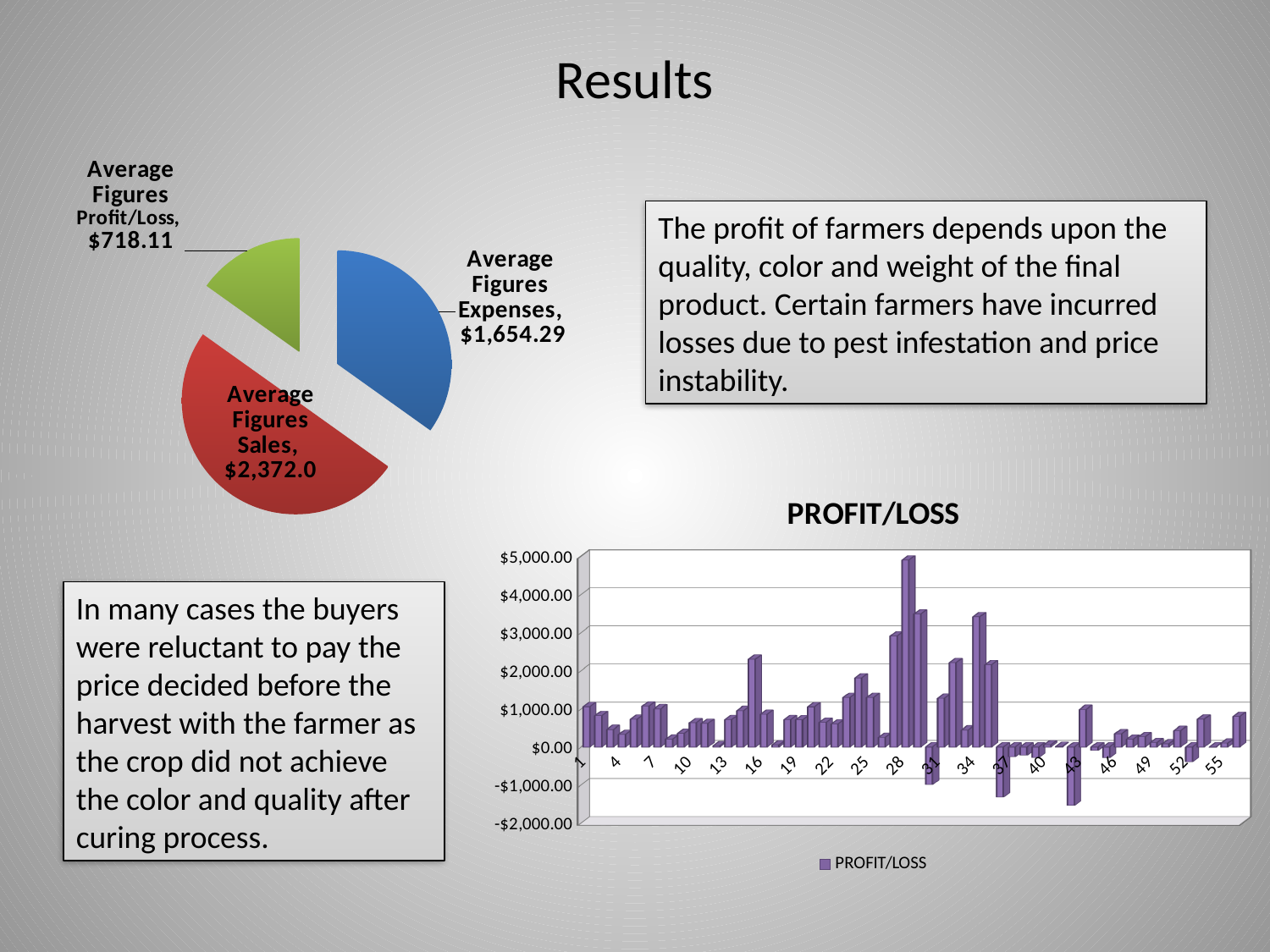
On the pie chart, what is the value for Average Figures Sales? $2,372.0 On the pie chart, what is the value for Average Figures Expenses? $1,654.29 On the pie chart, which is larger, Average Figures Expenses or Average Figures Profit/Loss? Average Figures Expenses What kind of chart is the chart on the left of the slide? Pie chart How many slices does the pie chart on the left have? 3 On the pie chart, which category has the largest value? Average Figures Sales How many series does the legend of the PROFIT/LOSS chart list? 1 On the PROFIT/LOSS chart, is the value for category 37 greater or less than $0.00? less On the PROFIT/LOSS chart, is the value for category 28 greater or less than $4,000.00? greater On the pie chart, what is the value for Average Figures Profit/Loss? $718.11 What kind of chart is the PROFIT/LOSS chart? Bar chart On the pie chart, which category has the smallest value? Average Figures Profit/Loss